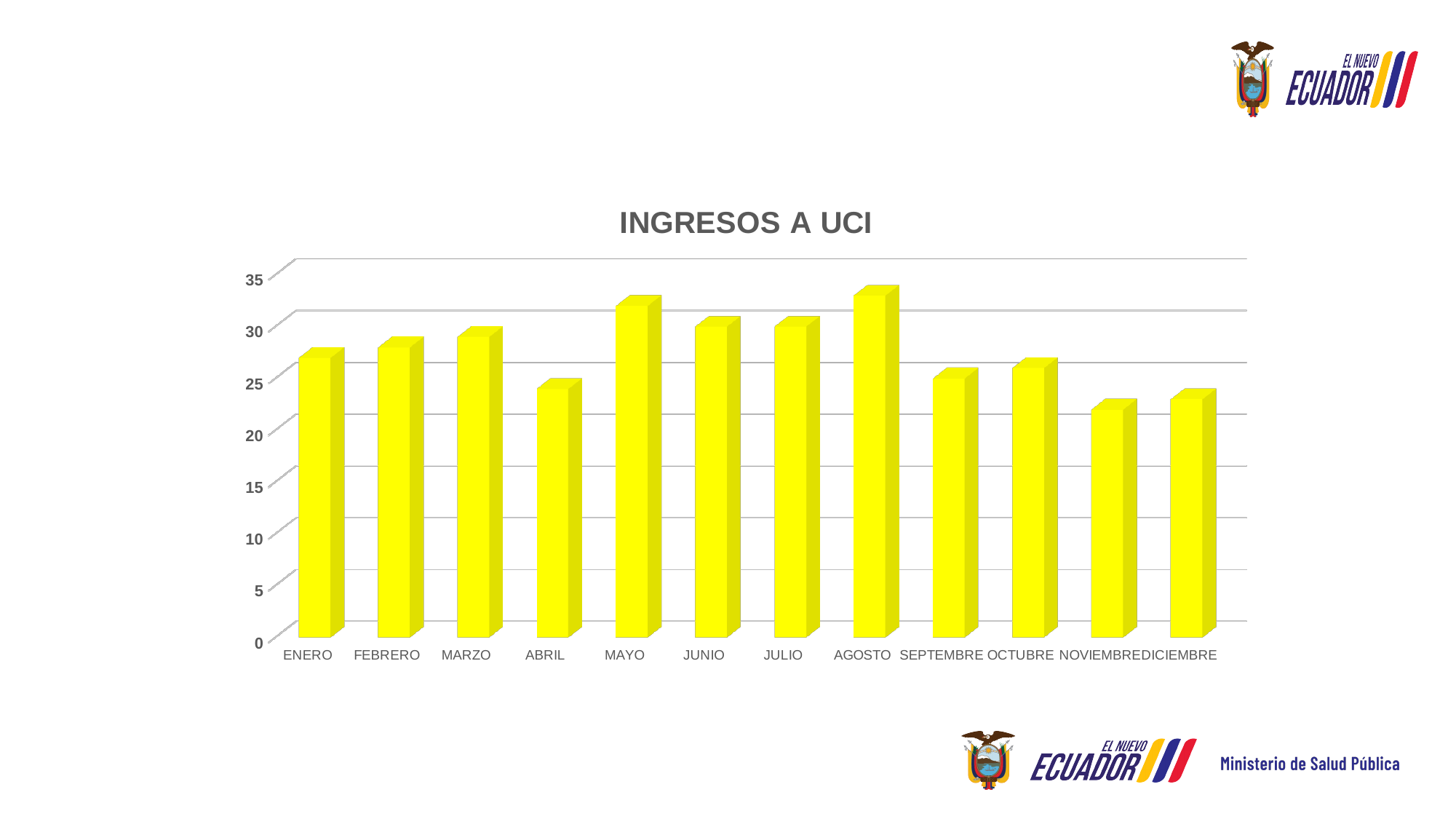
What colour are the bars in the chart? Yellow Is the value for NOVIEMBRE greater or less than 20? greater Which is larger, the value for AGOSTO or the value for NOVIEMBRE? AGOSTO How many months (categories) are shown on the x axis of the chart? 12 Is the value for ENERO greater or less than 25? greater Is the value for DICIEMBRE greater or less than 25? less What kind of chart is shown on the slide? Bar chart Which month has the highest value in the chart? AGOSTO Which is larger, the value for MAYO or the value for ABRIL? MAYO What is the title of the chart? INGRESOS A UCI